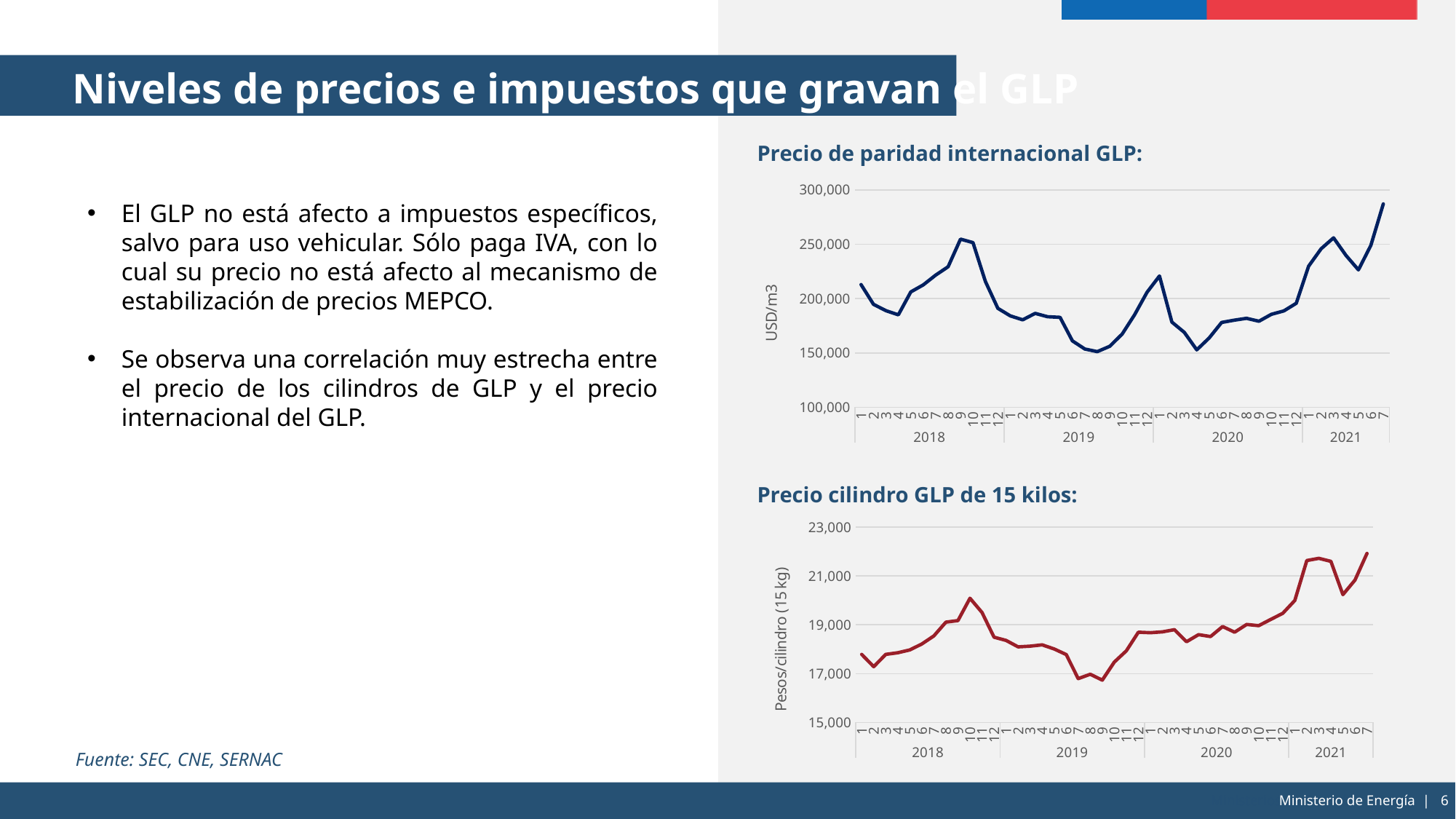
How many years are labelled on the x axis of the 'Precio de paridad internacional GLP' chart? 4 In the 'Precio de paridad internacional GLP' chart, which month and year has the highest value? month 7 of 2021 What is the y-axis unit label of the 'Precio de paridad internacional GLP' chart? USD/m3 In the 'Precio de paridad internacional GLP' chart, is the value for month 7 of 2021 greater or less than 250,000? greater What kind of chart is the 'Precio de paridad internacional GLP' chart? line chart In the 'Precio cilindro GLP de 15 kilos' chart, is the value for month 7 of 2021 greater or less than 21,000? greater What is the y-axis unit label of the 'Precio cilindro GLP de 15 kilos' chart? Pesos/cilindro (15 kg) In the 'Precio cilindro GLP de 15 kilos' chart, is the value at the end of the series (2021) higher or lower than at the start (2018)? higher What kind of chart is the 'Precio cilindro GLP de 15 kilos' chart? line chart In the 'Precio de paridad internacional GLP' chart, is the value for month 8 of 2019 greater or less than 200,000? less